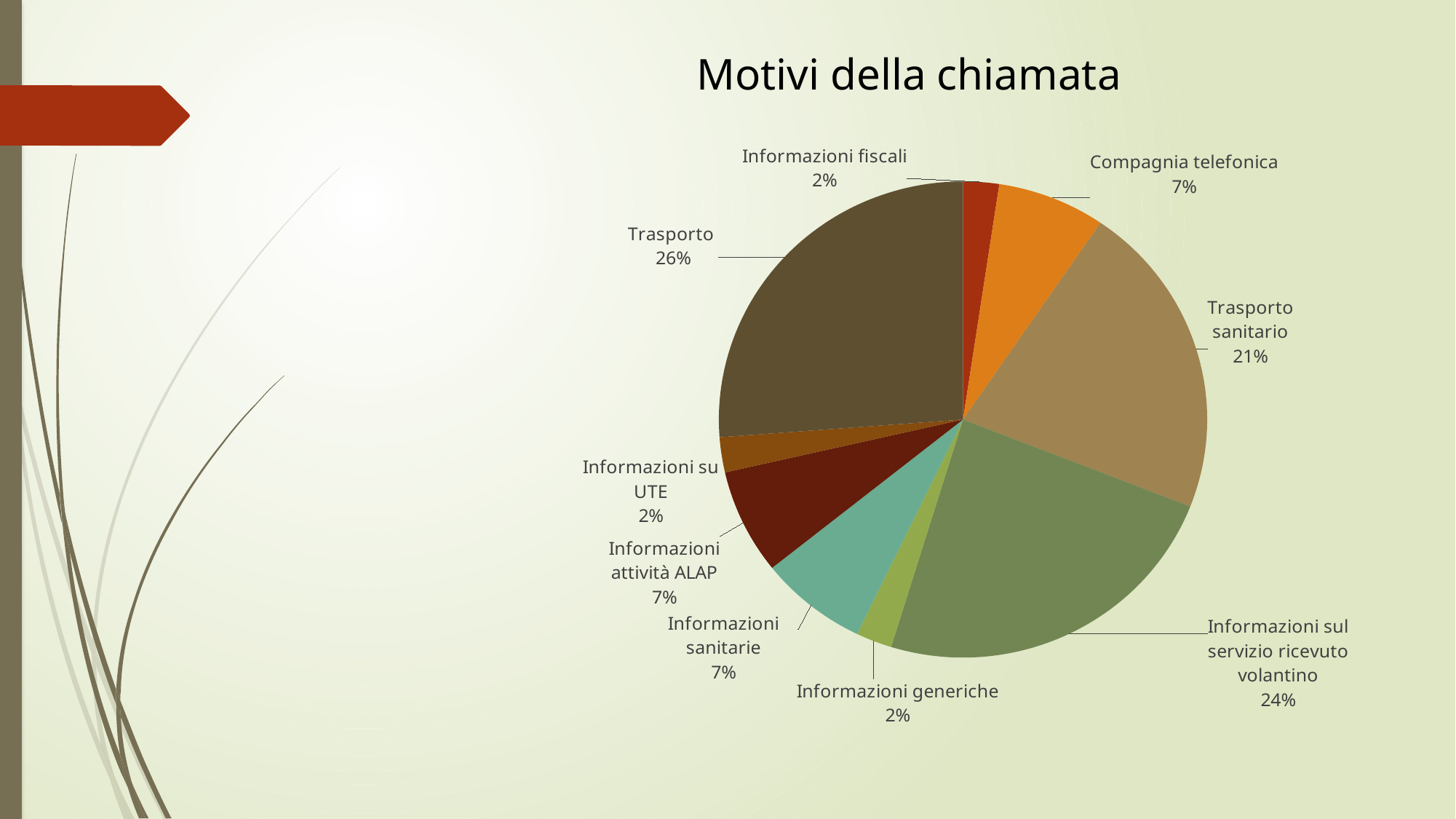
What percentage is shown for Compagnia telefonica? 7% What share of the pie is Trasporto? 26% Which is larger, the share for Informazioni sul servizio ricevuto volantino or the share for Trasporto sanitario? Informazioni sul servizio ricevuto volantino How many slices does the pie chart have? 9 What is the difference in percentage points between Informazioni attività ALAP and Informazioni su UTE? 5 What kind of chart is shown on the slide? Pie chart What percentage is shown for Informazioni generiche? 2% What share of the pie is Informazioni sul servizio ricevuto volantino? 24% Which category has the largest share of the pie? Trasporto What is the difference in percentage points between Trasporto and Trasporto sanitario? 5 What is the title of the chart? Motivi della chiamata What share of the pie is Trasporto sanitario? 21%